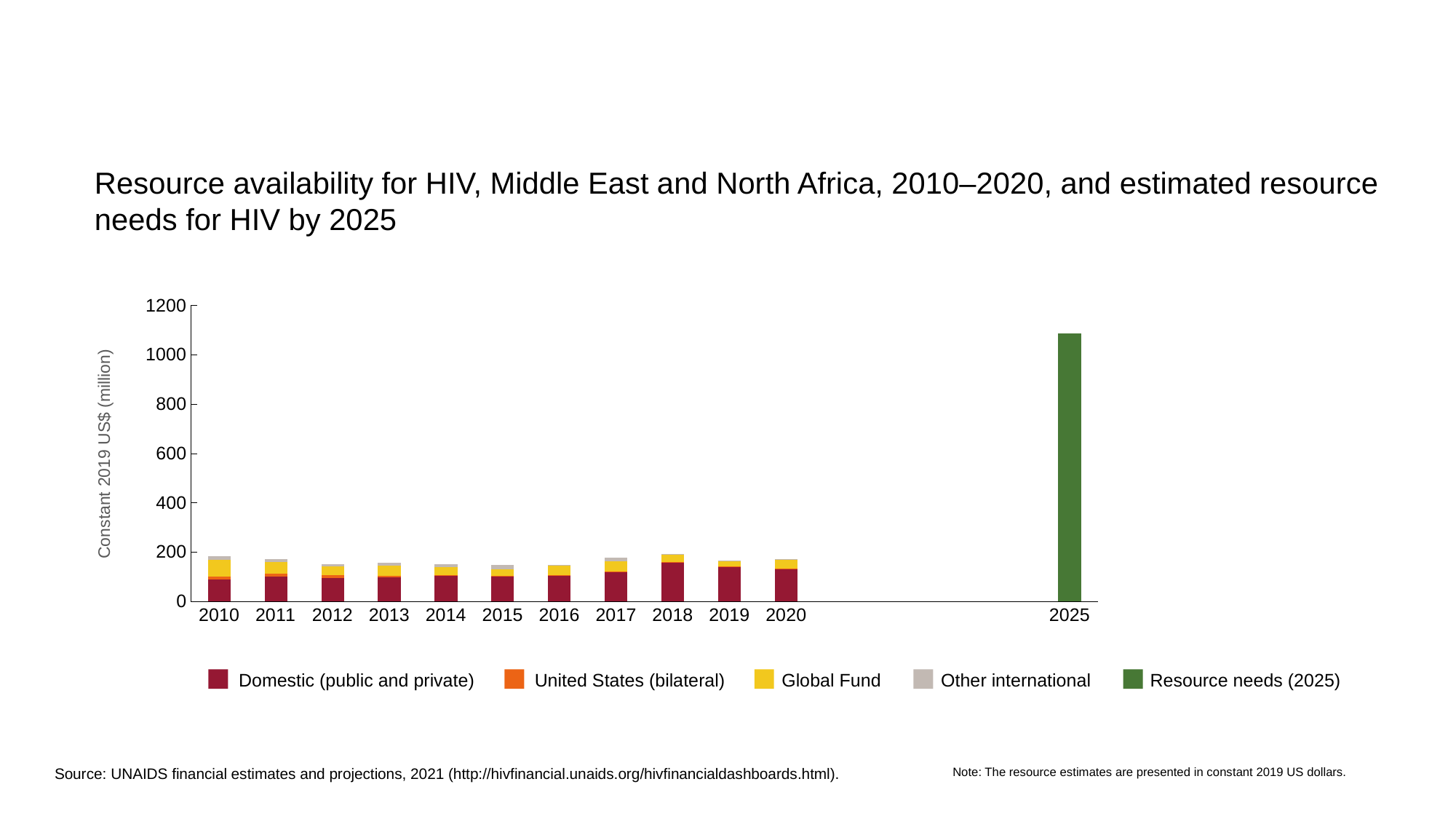
Which year has the tallest bar? 2025 Is the value for Resource needs (2025) greater or less than 1000? greater How many series does the legend list? 5 How many years are shown on the x axis? 12 Which is larger, the Domestic (public and private) segment in 2018 or in 2010? 2018 Which is larger, the bar for 2025 or the bar for 2020? 2025 Is the total bar for 2010 greater or less than 400? less Is the value for Resource needs (2025) greater or less than 1200? less What kind of chart is shown on the slide? Stacked bar chart Which series is shown in green? Resource needs (2025) What is the label of the y axis? Constant 2019 US$ (million)